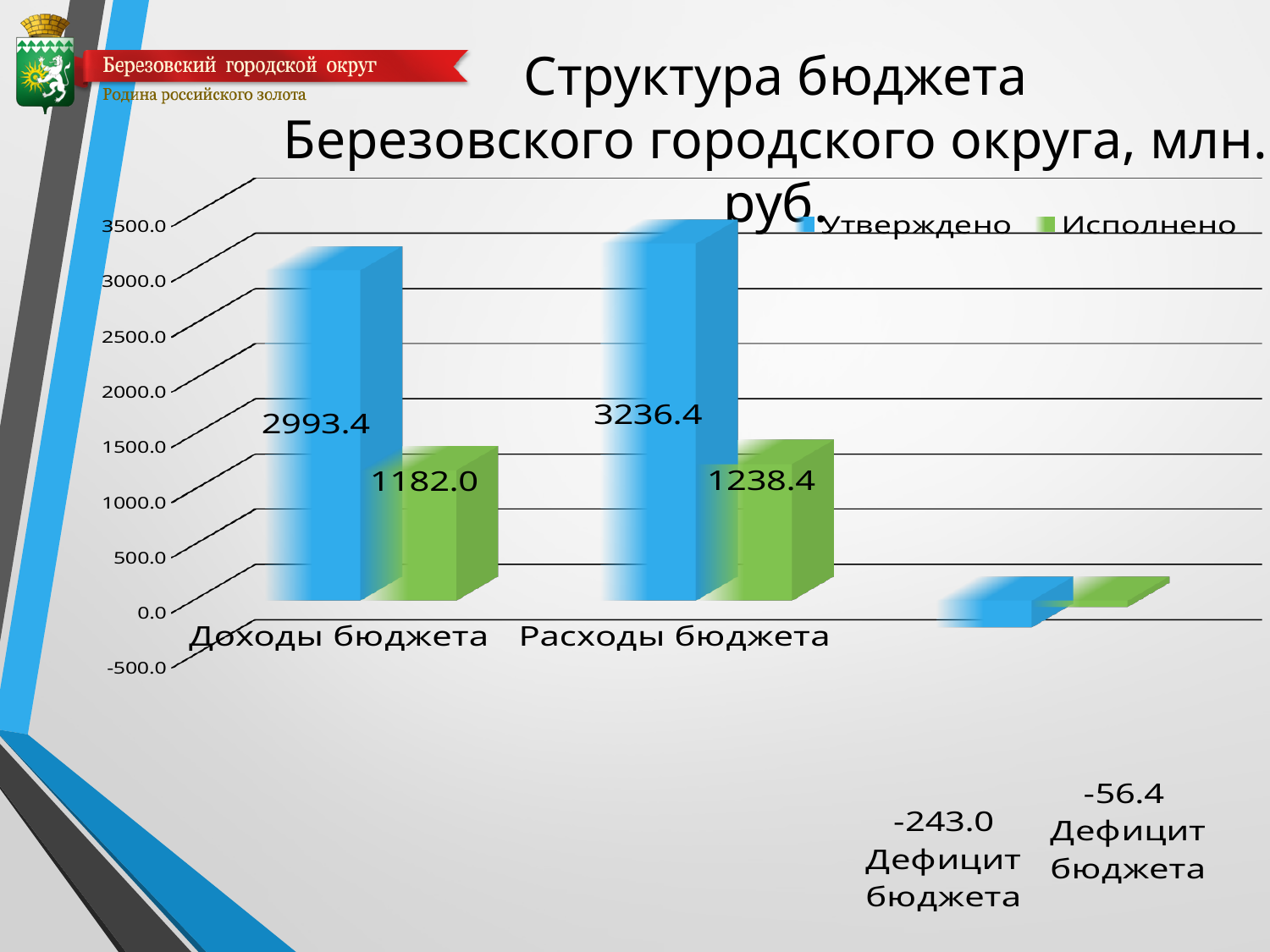
What kind of chart is shown on the slide? bar chart What is the approved (Утверждено) value for Дефицит бюджета? -243.0 What is the approved (Утверждено) value for Доходы бюджета? 2993.4 What is the executed (Исполнено) value for Дефицит бюджета? -56.4 Which category has the lowest executed (Исполнено) value? Дефицит бюджета What is the difference between the approved and executed values for Доходы бюджета? 1811.4 What is the executed (Исполнено) value for Расходы бюджета? 1238.4 Is the approved value for Расходы бюджета greater or less than 3000.0? greater How many categories are shown on the x axis? 3 Which category has the highest approved (Утверждено) value? Расходы бюджета Which is larger: the executed value for Доходы бюджета or the executed value for Расходы бюджета? Расходы бюджета How many series does the legend list? 2